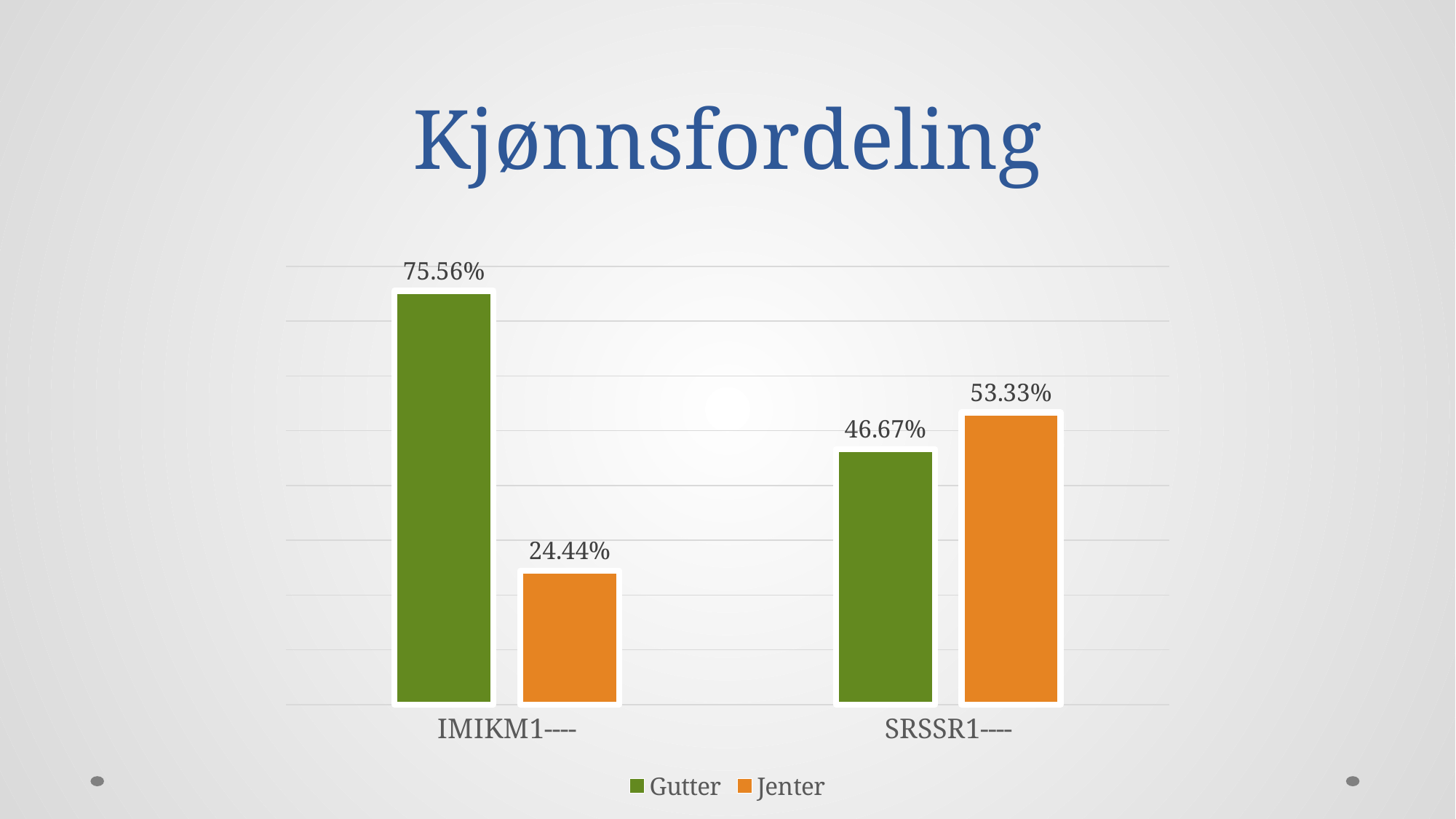
Which category has the lowest Jenter value? IMIKM1---- What is the value for Jenter in the SRSSR1---- category? 53.33% What is the value for Gutter in the SRSSR1---- category? 46.67% What is the value for Gutter in the IMIKM1---- category? 75.56% How many series does the legend list? 2 What is the difference between the Gutter and Jenter values in the IMIKM1---- category? 51.12% What kind of chart is shown on the slide? Bar chart Which category has the highest Gutter value? IMIKM1---- What is the title of the slide? Kjønnsfordeling In the SRSSR1---- category, which series has the larger value, Gutter or Jenter? Jenter What is the value for Jenter in the IMIKM1---- category? 24.44% How many categories are shown on the x axis? 2